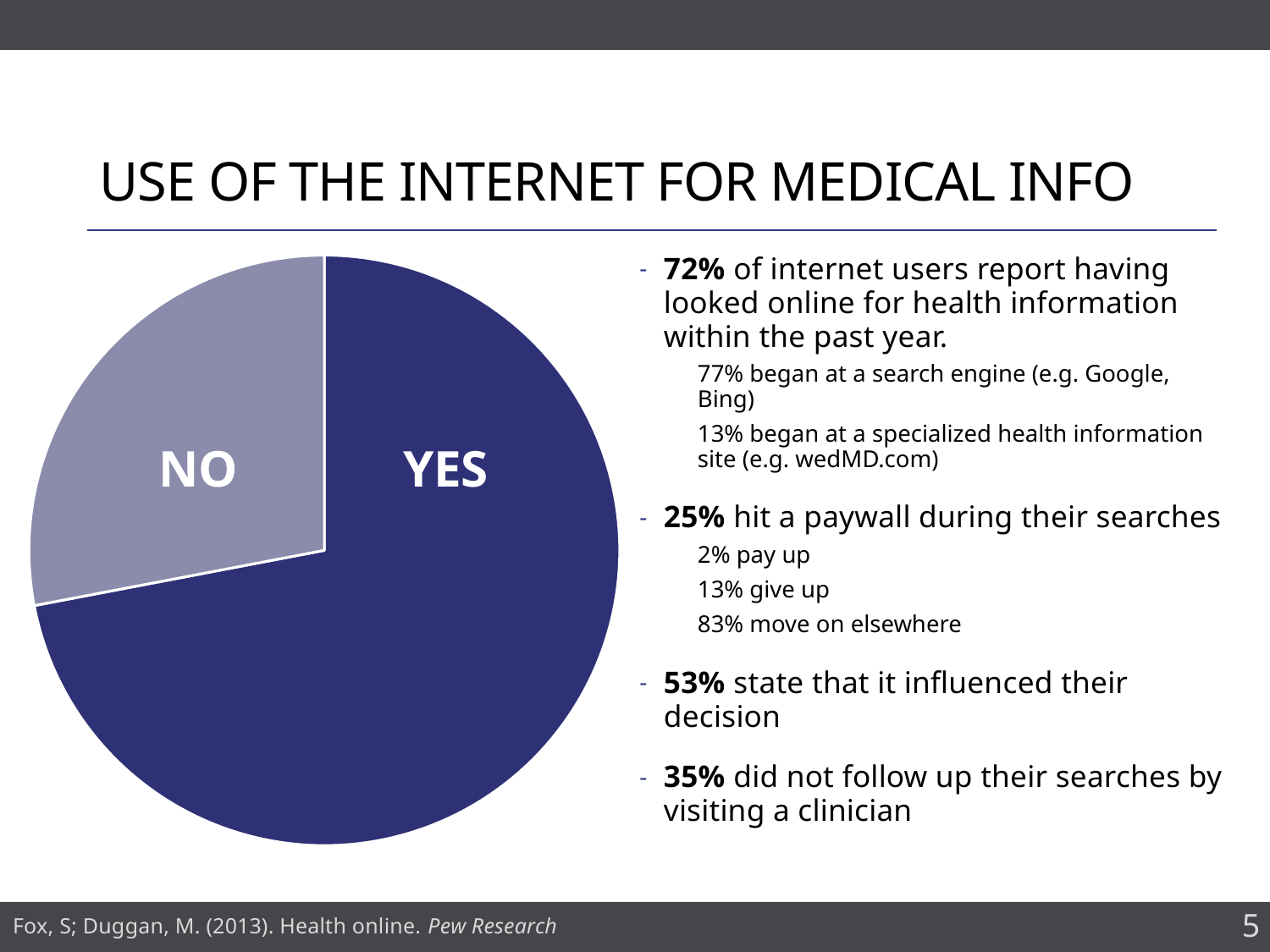
Which slice of the pie chart is the largest? YES Which slice of the pie chart is the smallest? NO Which slice is larger in the pie chart, YES or NO? YES How many slices does the pie chart have? 2 Does the YES slice take up more or less than half of the pie chart? More Which slice of the pie chart is coloured dark blue? YES Does the NO slice take up more or less than half of the pie chart? Less What are the labels of the two slices in the pie chart? YES and NO What kind of chart is shown on the slide? Pie chart